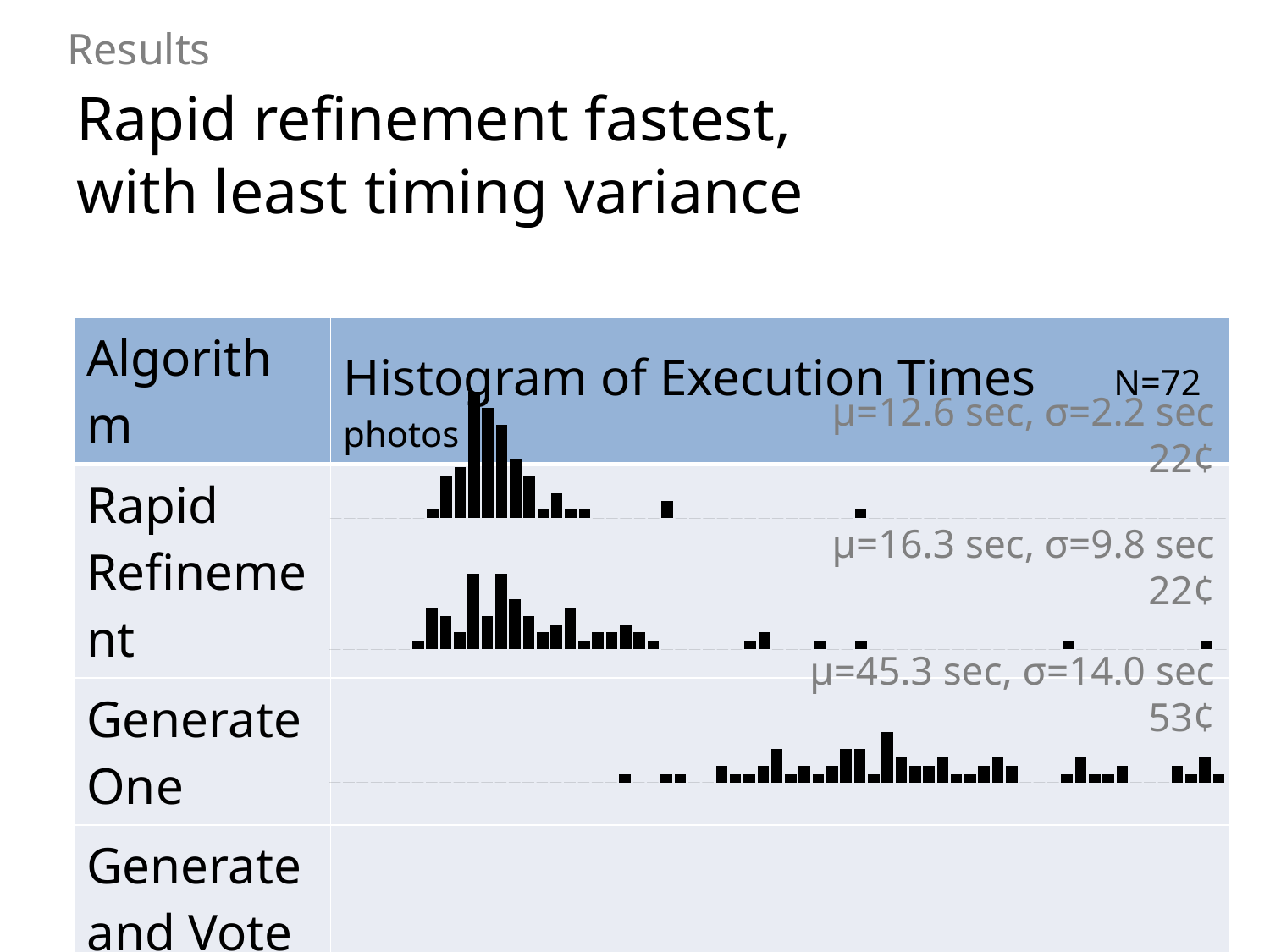
What is the standard deviation (σ) shown for the Generate and Vote histogram? 14.0 sec How many photos (N) does the Histogram of Execution Times cover? N=72 photos Which algorithm's histogram shows the lowest standard deviation of execution time? Rapid Refinement What is the difference between the mean execution times shown for Generate and Vote and Rapid Refinement? 32.7 sec Which algorithm's histogram shows the highest mean execution time? Generate and Vote What is the mean execution time (μ) shown for the Generate One histogram? 16.3 sec Which has the larger standard deviation, Generate One or Generate and Vote? Generate and Vote What is the standard deviation (σ) shown for the Rapid Refinement histogram? 2.2 sec How many histograms of execution times are shown on the slide? 3 What cost is shown for the Generate and Vote histogram? 53¢ What is the mean execution time (μ) shown for the Rapid Refinement histogram? 12.6 sec What kind of chart is shown in the Histogram of Execution Times table? histogram (bar chart)